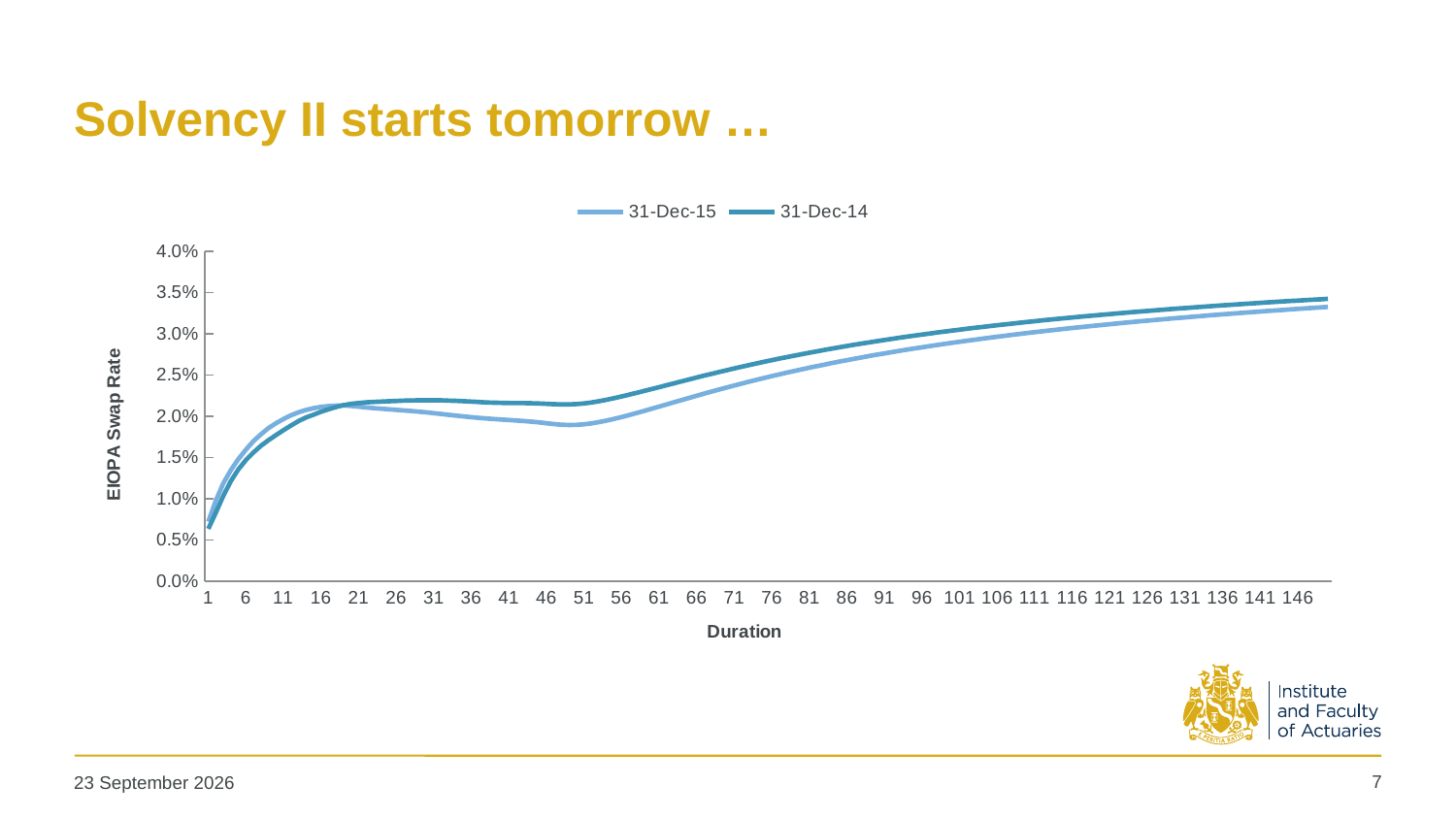
What is the label of the vertical axis? EIOPA Swap Rate At duration 146, which series has the higher swap rate, 31-Dec-15 or 31-Dec-14? 31-Dec-14 What are the two series named in the legend? 31-Dec-15 and 31-Dec-14 How many series does the legend list? 2 Is the 31-Dec-15 value at duration 51 greater or less than 2.0%? less Is the 31-Dec-14 value at duration 146 greater or less than 3.0%? greater At duration 51, which series has the higher swap rate, 31-Dec-15 or 31-Dec-14? 31-Dec-14 Does the 31-Dec-14 line generally rise or fall from duration 51 to duration 146? rise Is the 31-Dec-15 value at duration 1 greater or less than 1.0%? less Does the 31-Dec-15 line rise or fall between duration 21 and duration 51? fall What kind of chart is shown on the slide? line chart